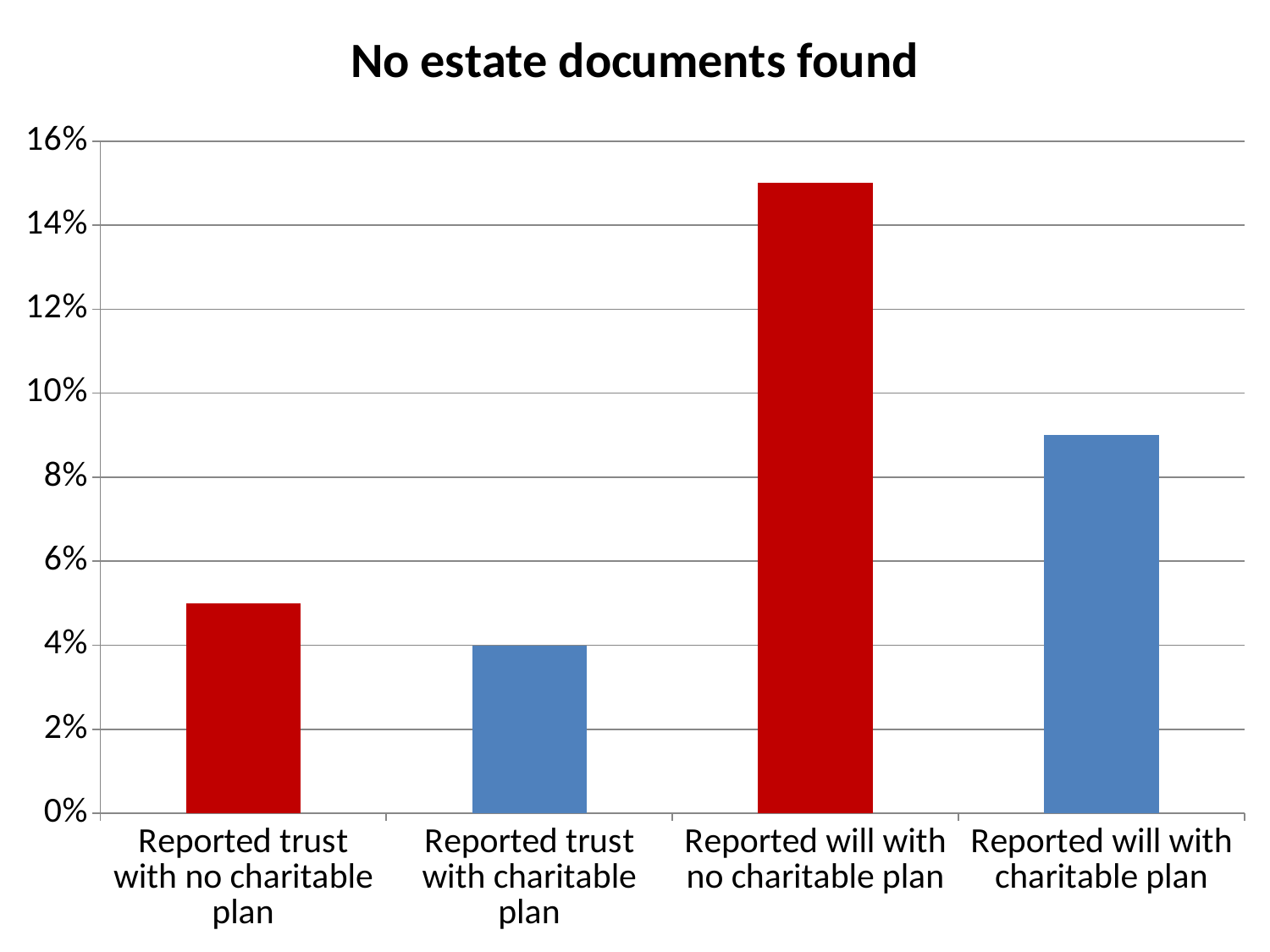
What is the title of the chart? No estate documents found Which is larger: the value for Reported will with no charitable plan or the value for Reported will with charitable plan? Reported will with no charitable plan Is the value for Reported will with no charitable plan greater or less than 14%? greater Is the value for Reported will with charitable plan greater or less than 10%? less Which category has the lowest value? Reported trust with charitable plan What colour are the bars for the categories with no charitable plan? red Which category has the highest value? Reported will with no charitable plan What kind of chart is shown on the slide? bar chart Is the value for Reported trust with no charitable plan greater or less than 4%? greater What is the value for Reported trust with charitable plan? 4% Which is larger: the value for Reported trust with no charitable plan or the value for Reported trust with charitable plan? Reported trust with no charitable plan How many categories are shown on the x axis? 4